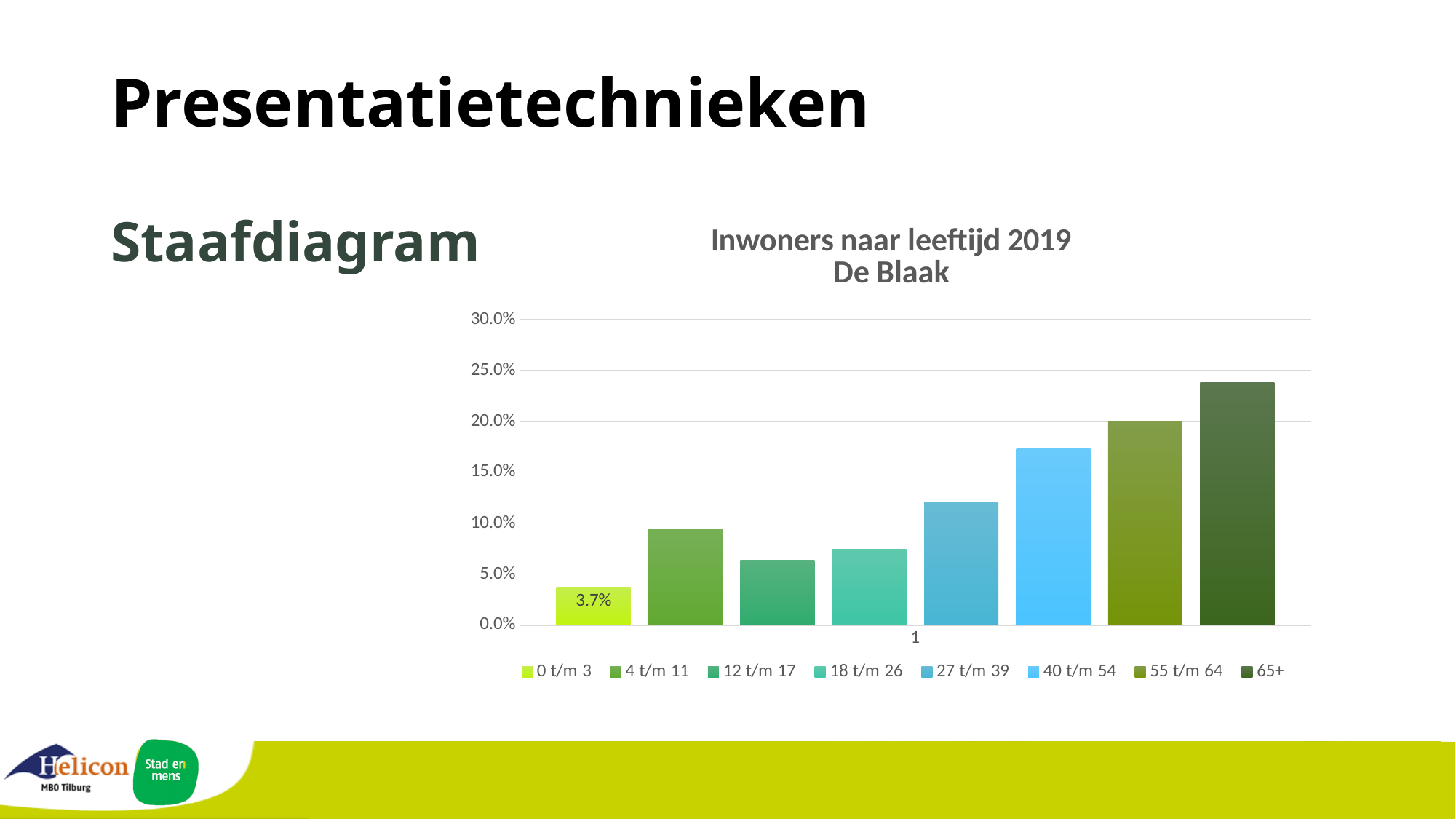
Which age group has the highest bar in the chart? 65+ Which is larger: the value for 4 t/m 11 or the value for 12 t/m 17? 4 t/m 11 Is the value for the 12 t/m 17 age group greater or less than 10.0%? less What is the title of the chart on the slide? Inwoners naar leeftijd 2019 De Blaak Which is larger: the value for 55 t/m 64 or the value for 40 t/m 54? 55 t/m 64 Which age group has the lowest bar in the chart? 0 t/m 3 How many series does the legend of the chart list? 8 What kind of chart is shown on the slide? Bar chart Is the value for the 65+ age group greater or less than 20.0%? greater Is the value for the 27 t/m 39 age group greater or less than 10.0%? greater What value is shown for the 0 t/m 3 age group in the 'Inwoners naar leeftijd 2019 De Blaak' chart? 3.7%